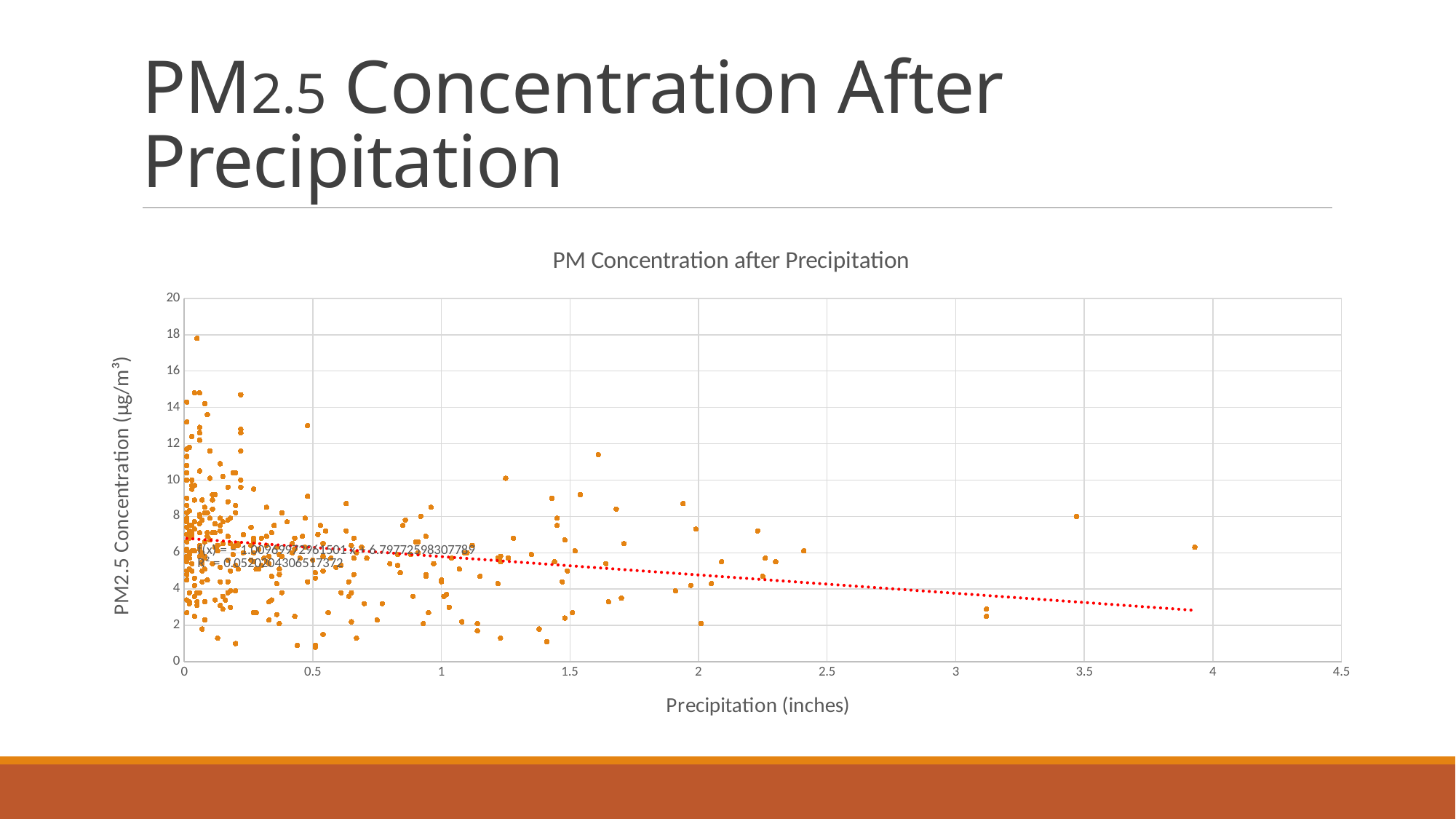
Are the PM2.5 concentrations of the points near 3.1 inches of precipitation greater or less than 4? less What is the maximum value shown on the y axis? 20 What is the label of the x axis? Precipitation (inches) What is the title of the chart? PM Concentration after Precipitation Is the trend line's value at 0 inches of precipitation greater or less than 6? greater Is the trend line's value at 3.5 inches of precipitation greater or less than 4? less Does the dotted trend line rise or fall as precipitation increases? Falls What kind of chart is shown on the slide? Scatter chart